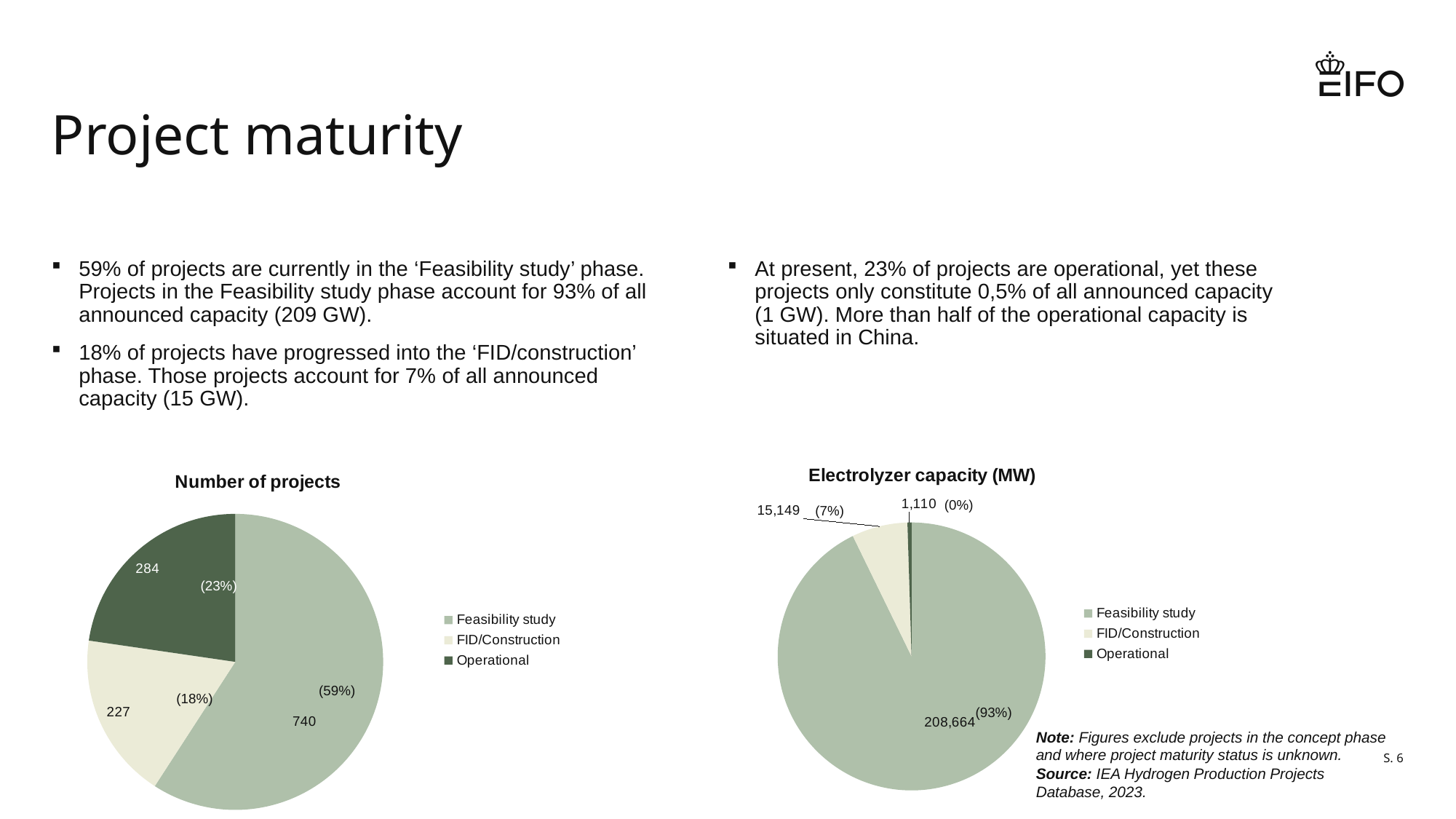
In the 'Electrolyzer capacity (MW)' chart, what is the capacity for Operational projects? 1,110 In the 'Number of projects' chart, which category has the fewest projects? FID/Construction How many categories does the legend of the 'Electrolyzer capacity (MW)' chart list? 3 In the 'Electrolyzer capacity (MW)' chart, which category has the largest capacity? Feasibility study In the 'Number of projects' chart, what share of projects are in FID/Construction? 18% In the 'Number of projects' chart, what is the difference between the Feasibility study and Operational project counts? 456 In the 'Number of projects' chart, how many projects are in the Feasibility study phase? 740 In the 'Electrolyzer capacity (MW)' chart, is the capacity for FID/Construction larger or smaller than for Operational? larger In the 'Number of projects' chart, how many projects are Operational? 284 In the 'Electrolyzer capacity (MW)' chart, what share of capacity is in the Feasibility study phase? 93% In the 'Electrolyzer capacity (MW)' chart, what is the capacity for FID/Construction? 15,149 What type of chart is used for 'Number of projects'? pie chart